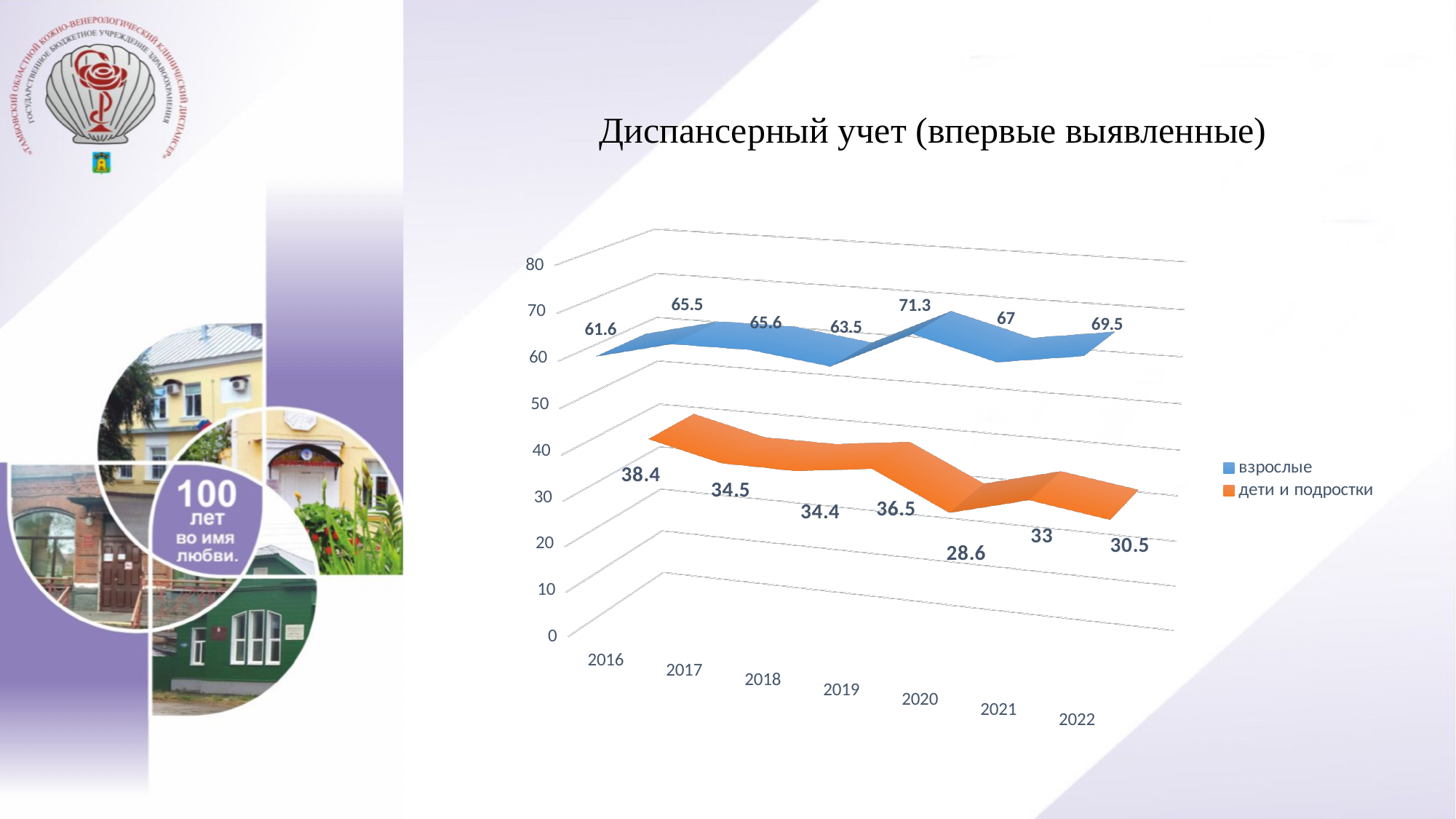
In which year is the value for взрослые lowest? 2016 What is the difference between взрослые and дети и подростки in 2020? 42.7 What is the value for дети и подростки in 2016? 38.4 What is the value for взрослые in 2020? 71.3 How many years are shown on the x axis? 7 By how much did the value for взрослые change from 2016 to 2022? 7.9 What is the value for дети и подростки in 2022? 30.5 In which year is the value for дети и подростки lowest? 2020 Which is larger for дети и подростки: the value in 2019 or the value in 2021? 2019 What is the title of the chart? Диспансерный учет (впервые выявленные) How many series does the legend list? 2 In which year is the value for взрослые highest? 2020